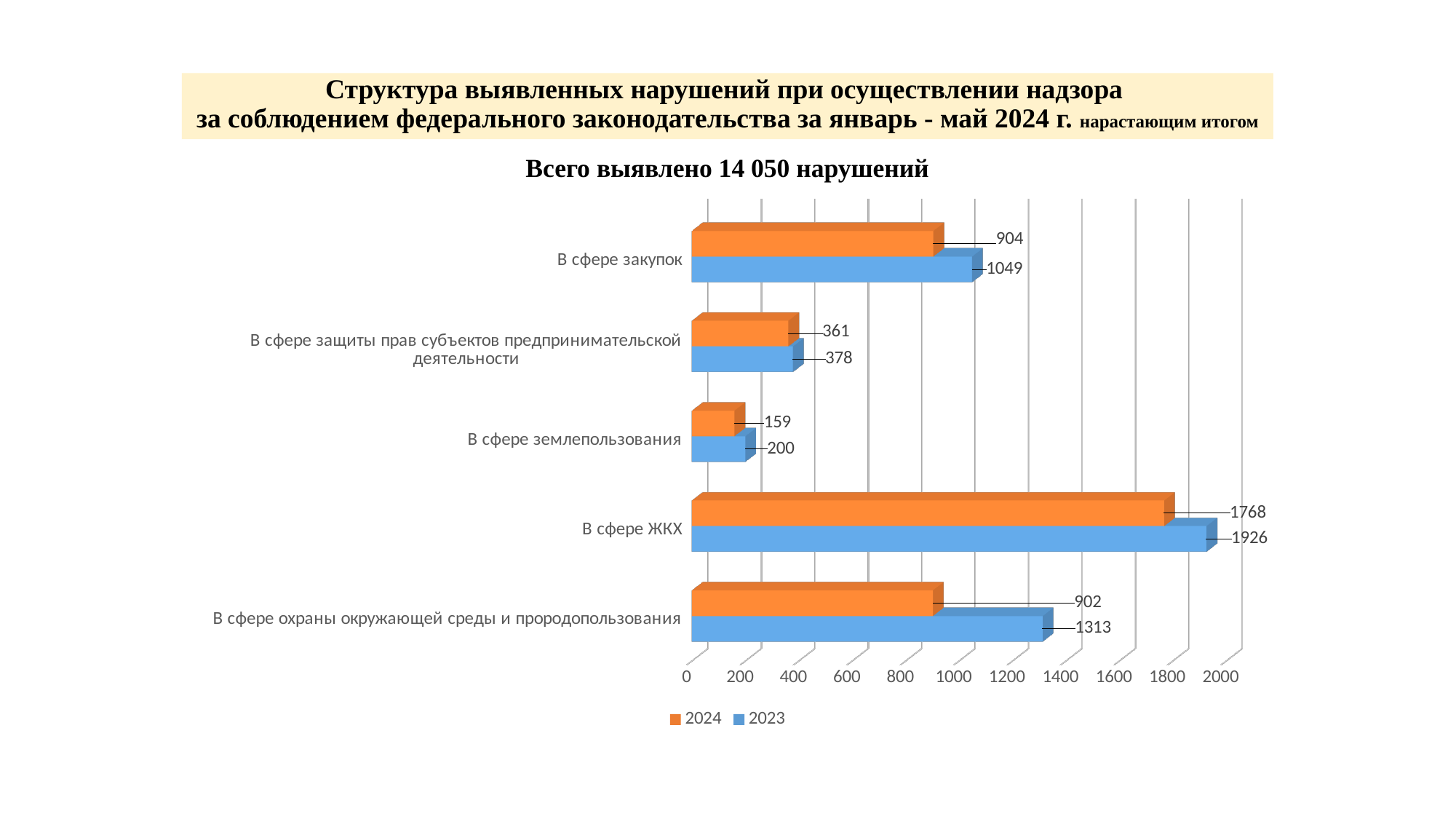
Which category has the highest 2023 value? В сфере ЖКХ What is the 2024 value for «В сфере ЖКХ»? 1768 Which is larger for «В сфере защиты прав субъектов предпринимательской деятельности»: the 2024 value or the 2023 value? 2023 What kind of chart is shown on the slide? Bar chart What is the difference between the 2023 and 2024 values for «В сфере охраны окружающей среды и прородопользования»? 411 Which category has the lowest 2024 value? В сфере землепользования How many categories are shown on the chart? 5 What is the difference between the 2023 and 2024 values for «В сфере ЖКХ»? 158 What is the 2023 value for «В сфере закупок»? 1049 How many series does the legend list? 2 What is the 2023 value for «В сфере охраны окружающей среды и прородопользования»? 1313 What is the 2024 value for «В сфере землепользования»? 159